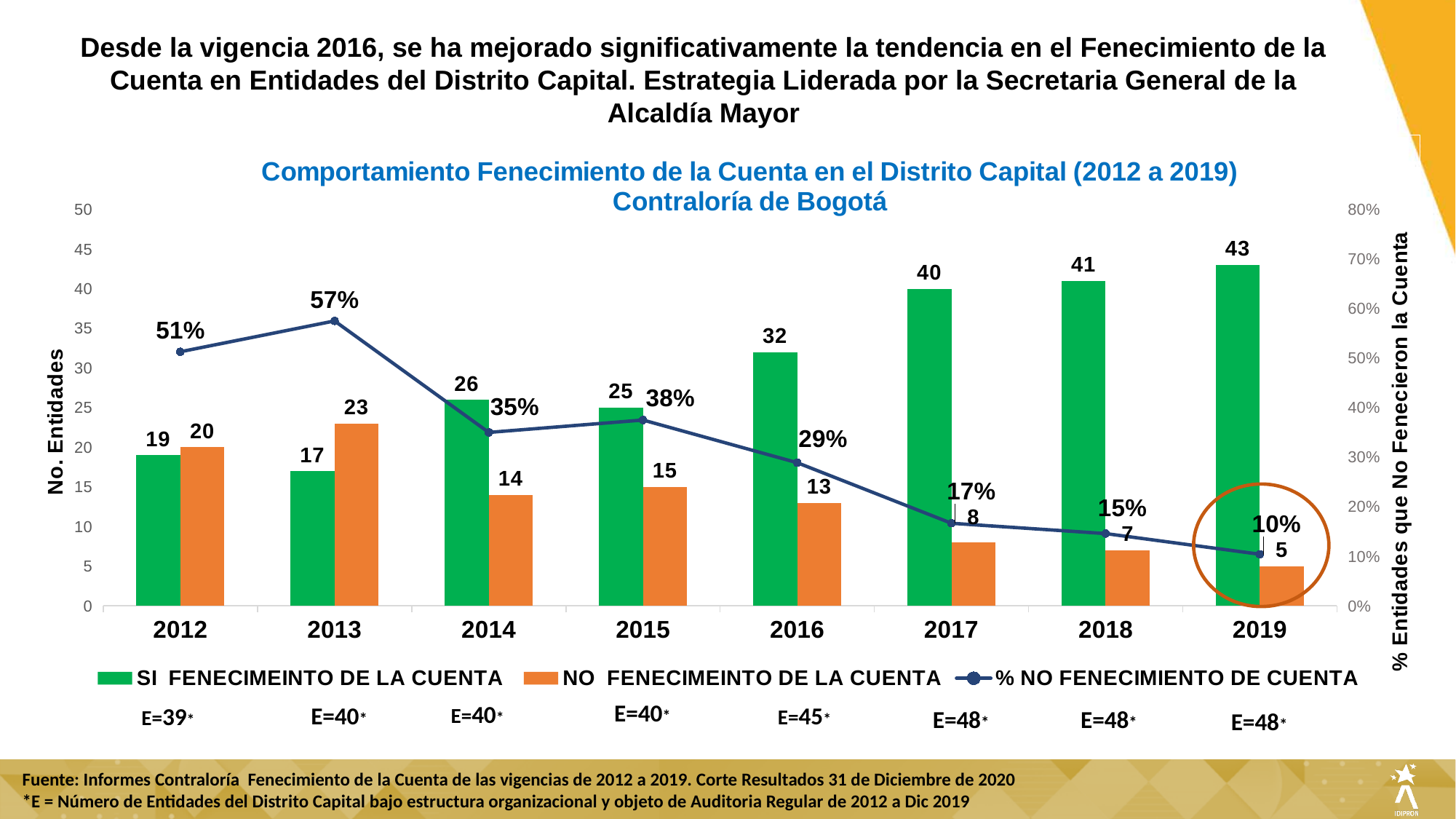
What is the difference between the SI FENECIMEINTO DE LA CUENTA value and the NO FENECIMEINTO DE LA CUENTA value in 2017? 32 What is the value of NO FENECIMEINTO DE LA CUENTA for 2013? 23 What is the title of the chart? Comportamiento Fenecimiento de la Cuenta en el Distrito Capital (2012 a 2019) Contraloría de Bogotá In which year is the % NO FENECIMIENTO DE CUENTA highest? 2013 How many years are shown on the x axis? 8 What is the value of SI FENECIMEINTO DE LA CUENTA for 2016? 32 In which year is the NO FENECIMEINTO DE LA CUENTA value lowest? 2019 In which year is the SI FENECIMEINTO DE LA CUENTA value highest? 2019 What is the % NO FENECIMIENTO DE CUENTA value for 2014? 35% Which is larger in 2012: SI FENECIMEINTO DE LA CUENTA or NO FENECIMEINTO DE LA CUENTA? NO FENECIMEINTO DE LA CUENTA Does the % NO FENECIMIENTO DE CUENTA line rise or fall from 2016 to 2019? fall How many series does the legend list? 3